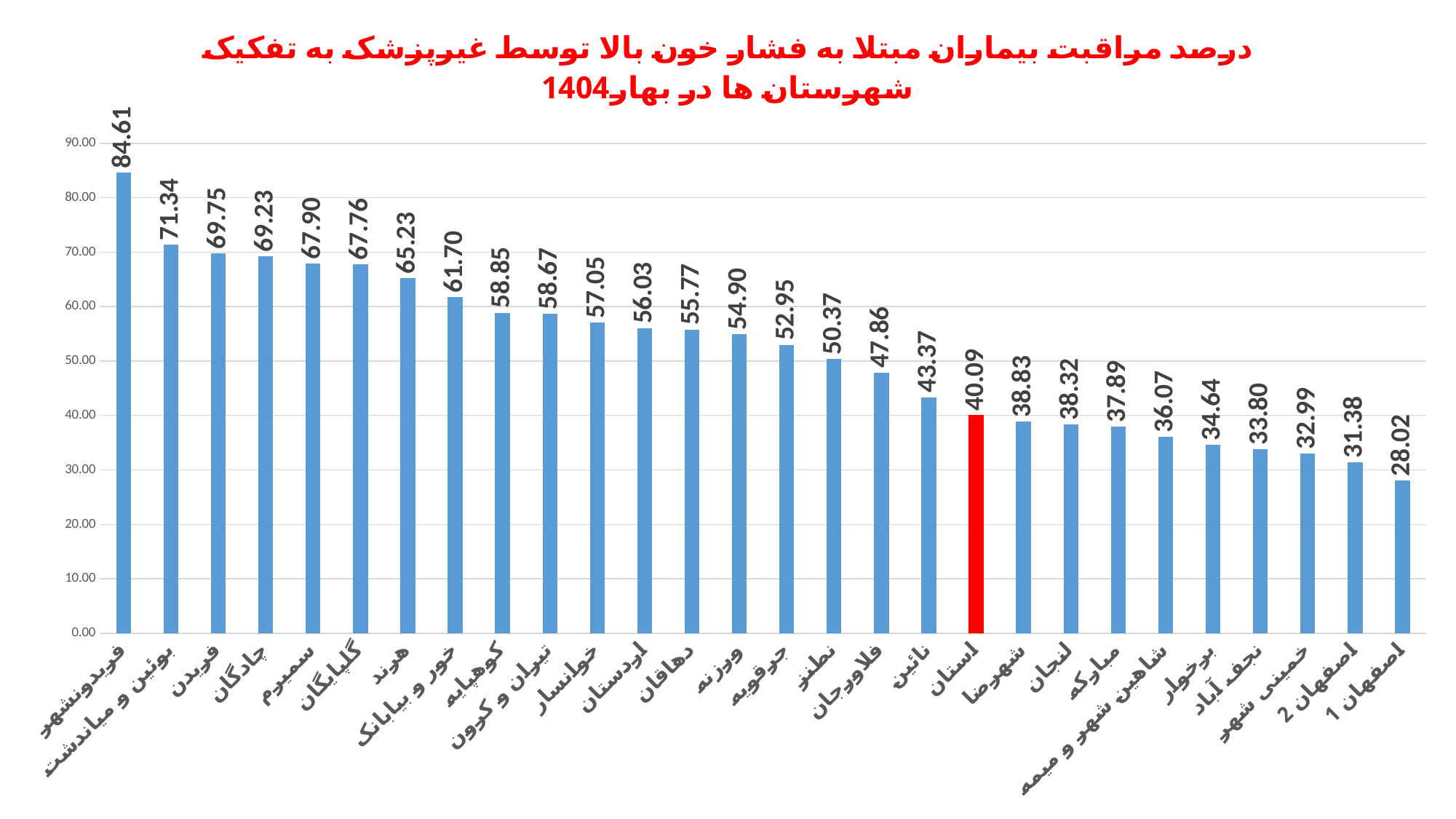
Is the value for فلاورجان greater or less than 50.00? less Which bar is coloured red instead of blue? استان What is the value for فریدونشهر? 84.61 Which category has the highest value? فریدونشهر What is the difference between the values for فریدونشهر and اصفهان 1? 56.59 How many bars are shown in the chart? 28 What is the difference between the values for استان and شهرضا? 1.26 What is the value for نطنز? 50.37 What is the value for استان (the red bar)? 40.09 Which category has the lowest value? اصفهان 1 Which is larger, the value for هرند or the value for خوانسار? هرند What kind of chart is shown on the slide? bar chart